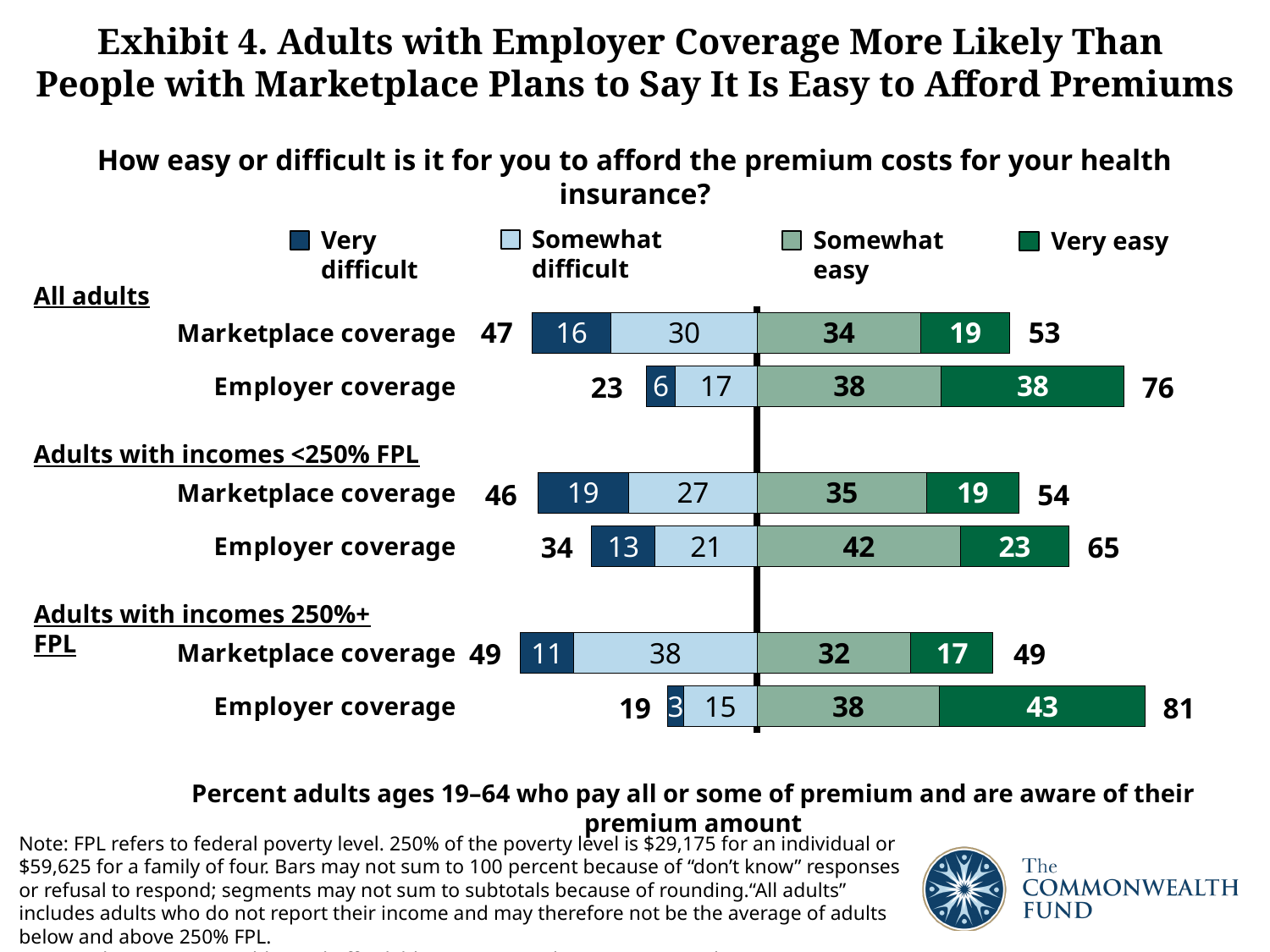
Among adults with incomes below 250% FPL, which has the larger 'Somewhat easy' value: marketplace coverage or employer coverage? Employer coverage Which bar has the highest 'Very easy' value? Employer coverage, adults with incomes 250%+ FPL Which legend entry is shown in dark green? Very easy Which bar has the lowest 'Very difficult' value? Employer coverage, adults with incomes 250%+ FPL Among all adults with marketplace coverage, what is the combined total of the 'Somewhat easy' and 'Very easy' segments? 53 How many series does the legend list? 4 Among all adults, how much higher is the 'Very easy' value for employer coverage than for marketplace coverage? 19 Among adults with incomes 250%+ FPL, what percentage with marketplace coverage say it is somewhat difficult to afford premiums? 38 What percentage of all adults with employer coverage say it is very easy to afford premiums? 38 What kind of chart is shown on the slide? Stacked bar chart How many bars are plotted in the chart? 6 Among adults with incomes below 250% FPL, what percentage with marketplace coverage say it is very difficult to afford premiums? 19